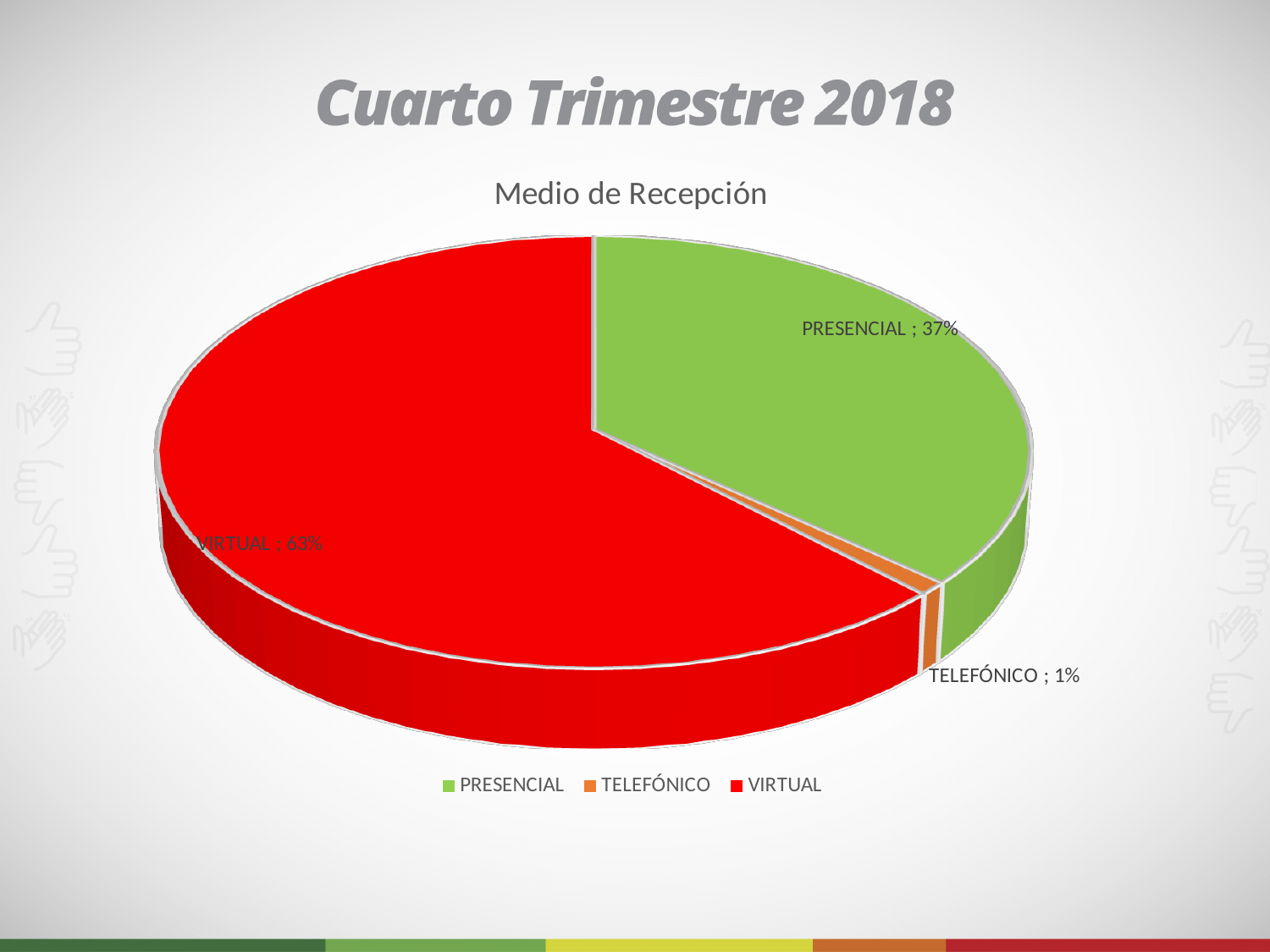
What is the difference in percentage points between VIRTUAL and PRESENCIAL? 26 What share of the pie does VIRTUAL represent? 63% What is the title of the chart? Medio de Recepción What colour is the VIRTUAL slice? red Which category has the largest slice of the pie? VIRTUAL How many entries does the legend list? 3 Which category has the smallest slice of the pie? TELEFÓNICO What share of the pie does PRESENCIAL represent? 37% What kind of chart is shown on the slide? pie chart Which is larger, the share for PRESENCIAL or the share for TELEFÓNICO? PRESENCIAL How many categories are shown in the pie chart? 3 What share of the pie does TELEFÓNICO represent? 1%